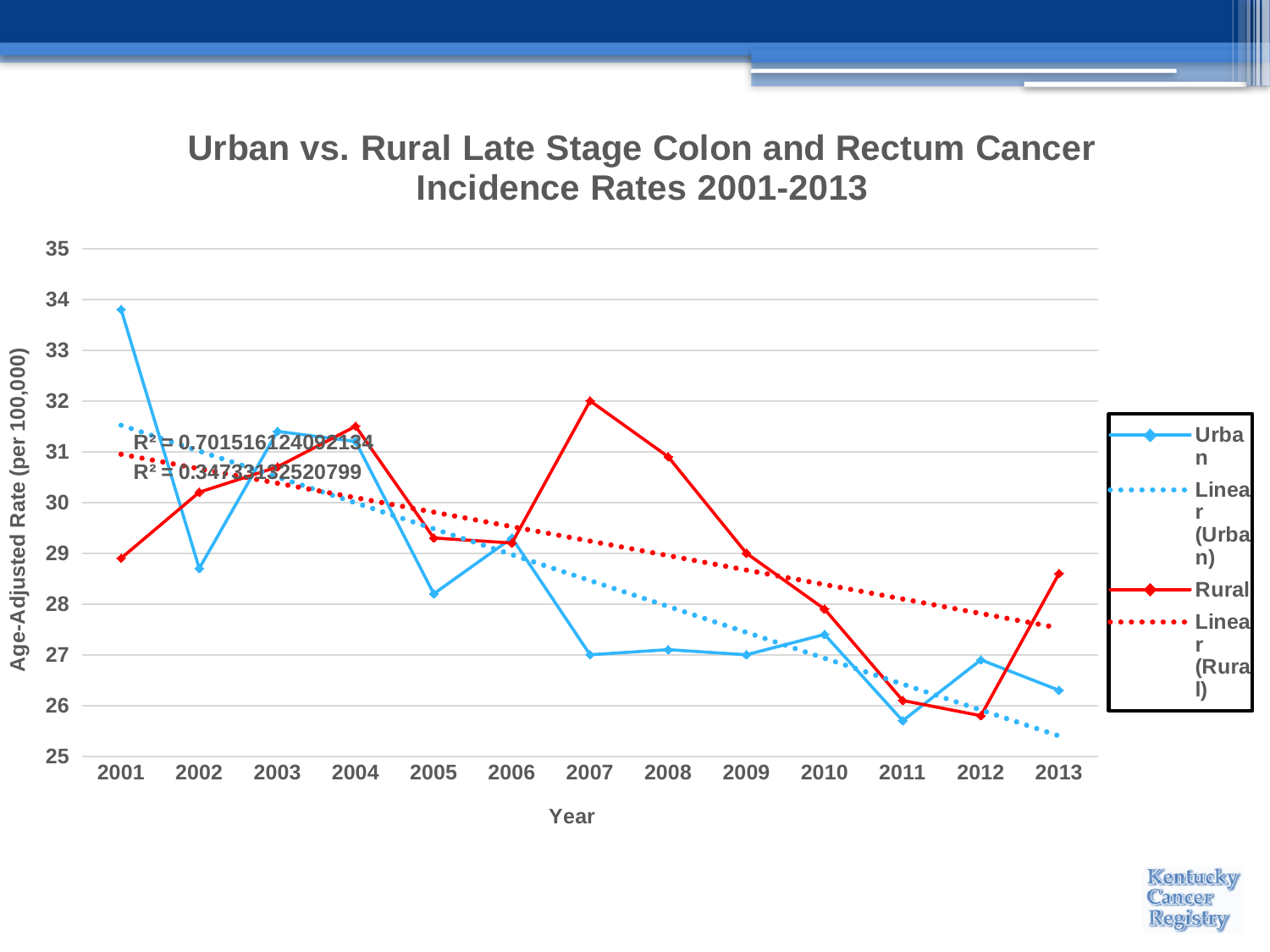
Is the Urban value for 2011 greater or less than 26? less How many entries does the legend list? 4 Is the Urban value for 2001 greater or less than 33? greater Is the Rural value for 2007 greater or less than 31? greater What kind of chart is shown on the slide? Line chart How many years are plotted along the x axis? 13 In which year is the Urban late stage incidence rate highest? 2001 What is the title of the y axis? Age-Adjusted Rate (per 100,000) In 2007, which series has the higher value, Urban or Rural? Rural In 2001, which series has the higher value, Urban or Rural? Urban In which year is the Urban late stage incidence rate lowest? 2011 In which year is the Rural late stage incidence rate highest? 2007